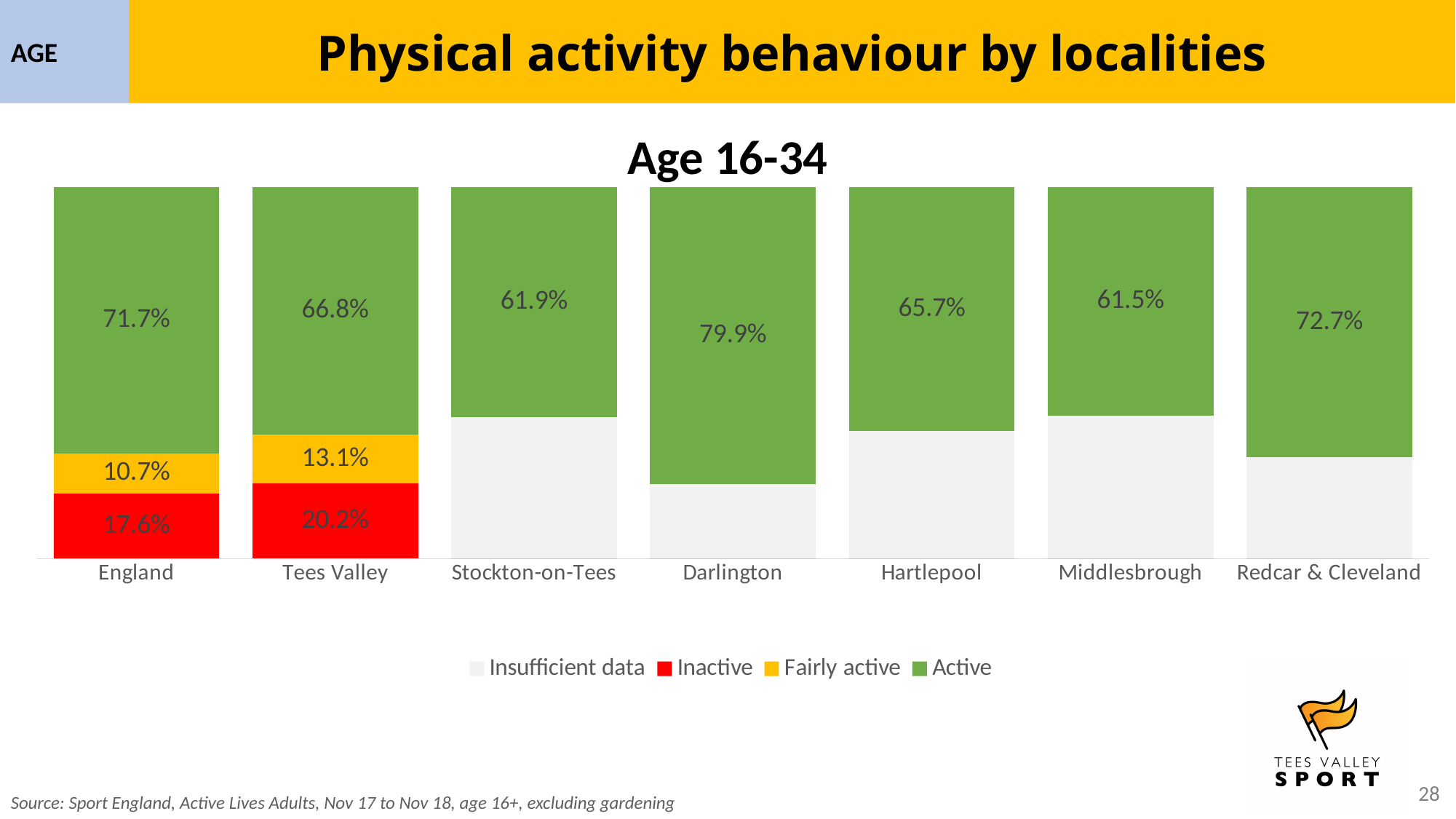
What is the difference between the Active percentages for Darlington and Stockton-on-Tees? 18.0% What kind of chart is shown on the slide? Stacked bar chart What is the Fairly active percentage for England? 10.7% How many localities are shown on the x axis? 7 Which locality has the lowest Active percentage? Middlesbrough How many series does the legend list? 4 What is the title of the chart? Age 16-34 What is the Active percentage for Redcar & Cleveland? 72.7% What is the Inactive percentage for Tees Valley? 20.2% Which has a higher Inactive percentage, England or Tees Valley? Tees Valley Which locality has the highest Active percentage? Darlington What is the Active percentage for Darlington? 79.9%